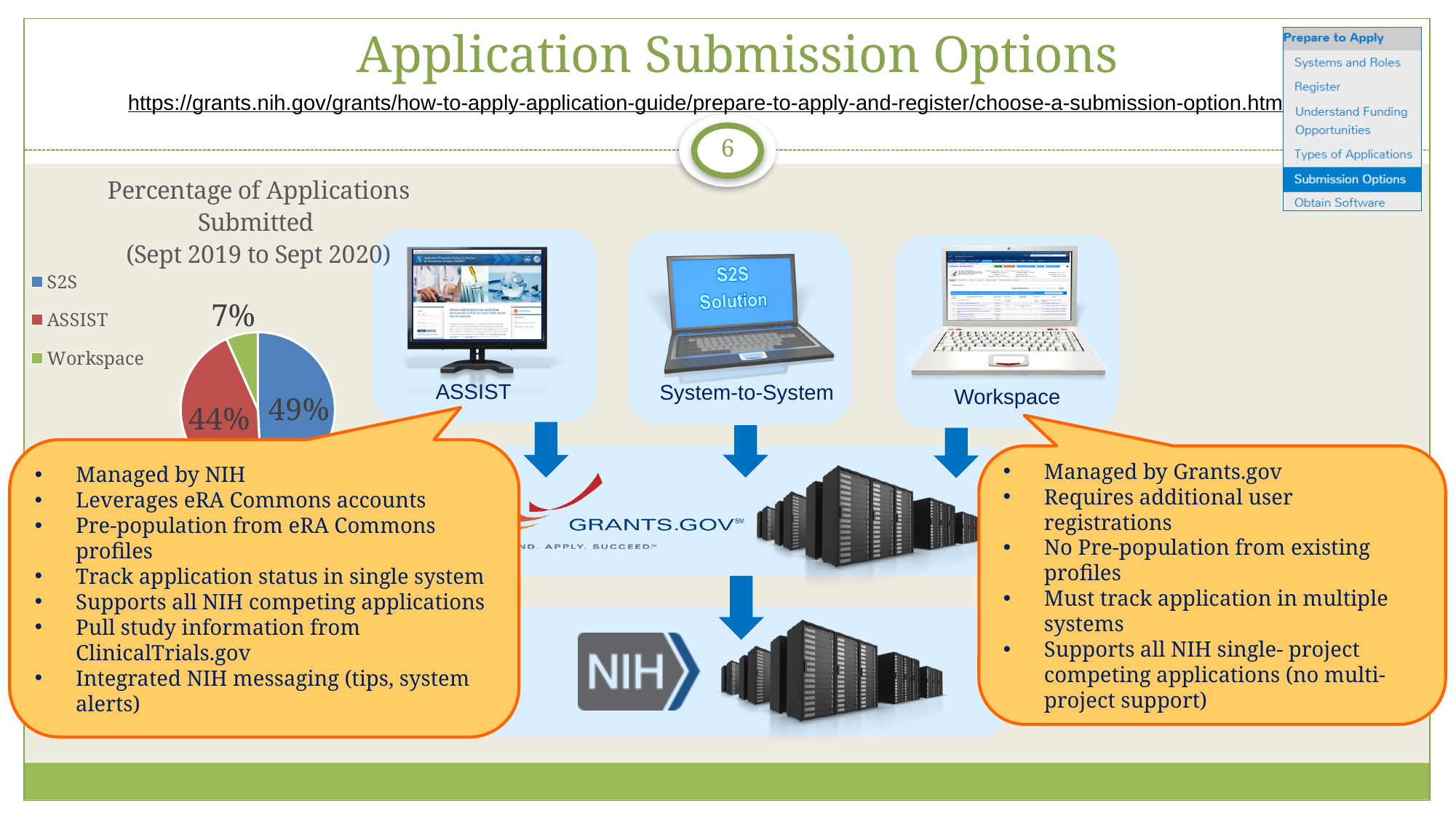
What is the difference in percentage points between the S2S and ASSIST slices? 5% What kind of chart is used to show the percentage of applications submitted? Pie chart What percentage of applications were submitted via Workspace? 7% What percentage of applications were submitted via ASSIST? 44% How many categories does the pie chart show? 3 Which has a larger share of applications, ASSIST or Workspace? ASSIST What percentage of applications were submitted via S2S? 49% What is the title of the pie chart? Percentage of Applications Submitted (Sept 2019 to Sept 2020) What is the difference in percentage points between the ASSIST and Workspace slices? 37% Which submission option has the largest share of applications in the pie chart? S2S Which submission option has the smallest share of applications in the pie chart? Workspace Which colour represents ASSIST in the pie chart? Red